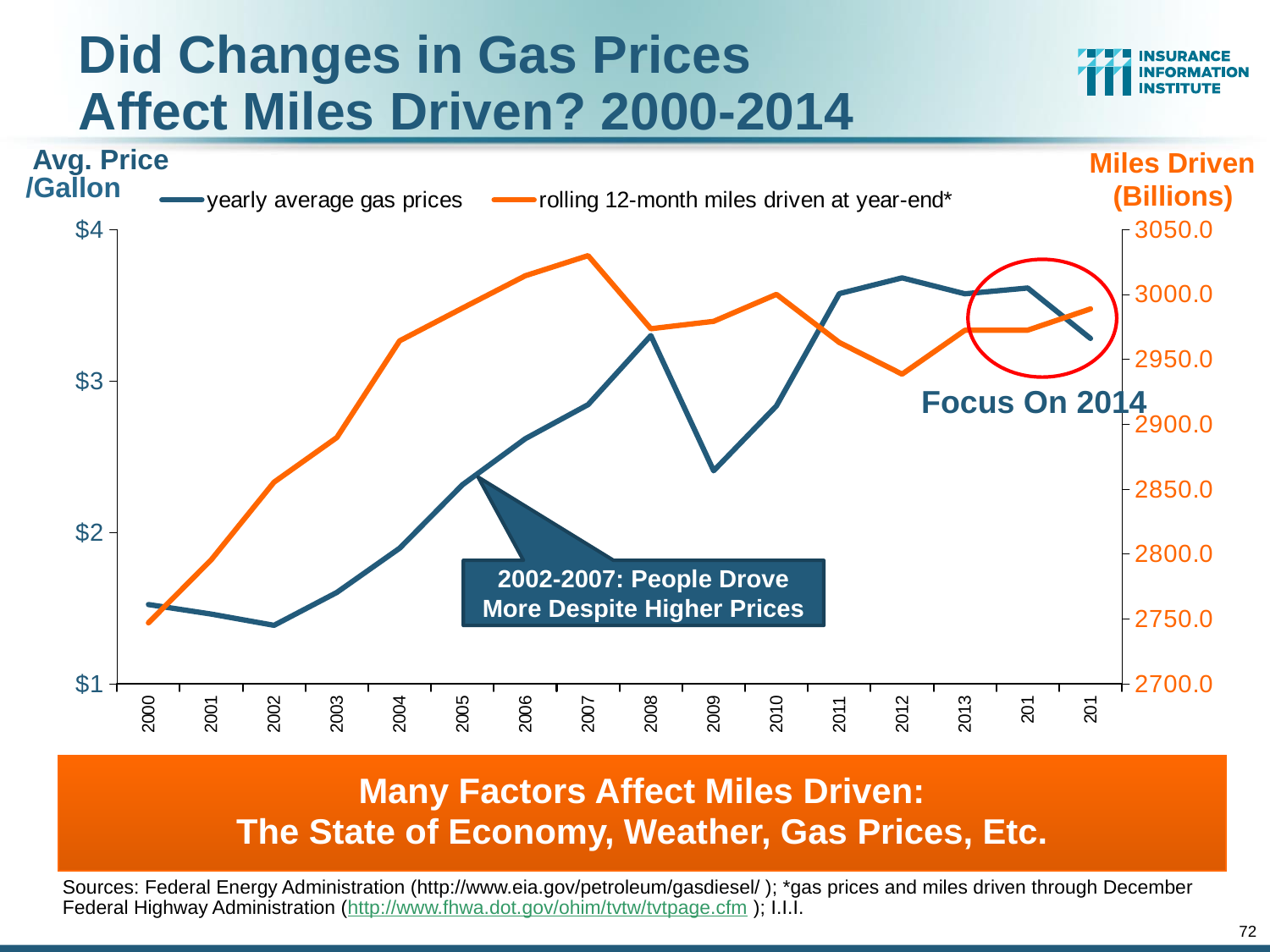
What kind of chart is shown on the slide? Line chart What is the label on the left vertical axis? Avg. Price /Gallon Is the yearly average gas price for 2008 greater or less than $3? greater Is the rolling 12-month miles driven for 2000 greater or less than 2800.0? less How many series does the chart's legend list? 2 In which year is the yearly average gas price lowest? 2002 In which year is the rolling 12-month miles driven at year-end highest? 2007 Is the yearly average gas price for 2009 greater or less than $3? less In which year is the rolling 12-month miles driven at year-end lowest? 2000 Which is larger, the yearly average gas price in 2008 or in 2009? 2008 Which series is plotted in orange? rolling 12-month miles driven at year-end*